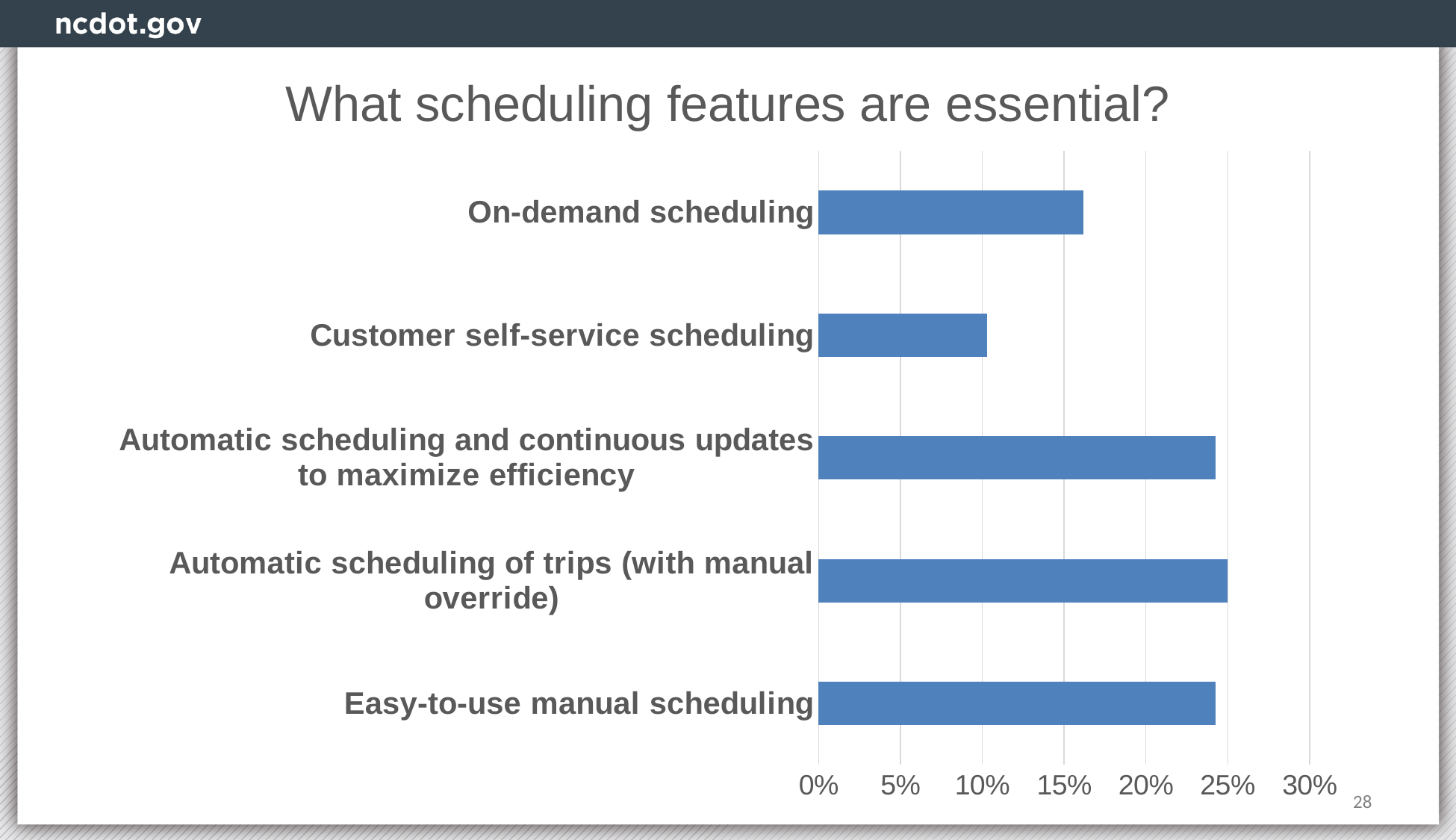
Is the value for Automatic scheduling and continuous updates to maximize efficiency greater or less than 20%? greater What is the highest tick label shown on the horizontal axis? 30% Which has the larger value: On-demand scheduling or Customer self-service scheduling? On-demand scheduling Is the value for Easy-to-use manual scheduling greater or less than 20%? greater Is the value for Automatic scheduling of trips (with manual override) greater or less than 20%? greater What kind of chart is shown on the slide? bar chart What is the title of the chart? What scheduling features are essential? Which scheduling feature has the lowest value in the chart? Customer self-service scheduling Which has the larger value: Easy-to-use manual scheduling or On-demand scheduling? Easy-to-use manual scheduling How many scheduling features (categories) are plotted in the chart? 5